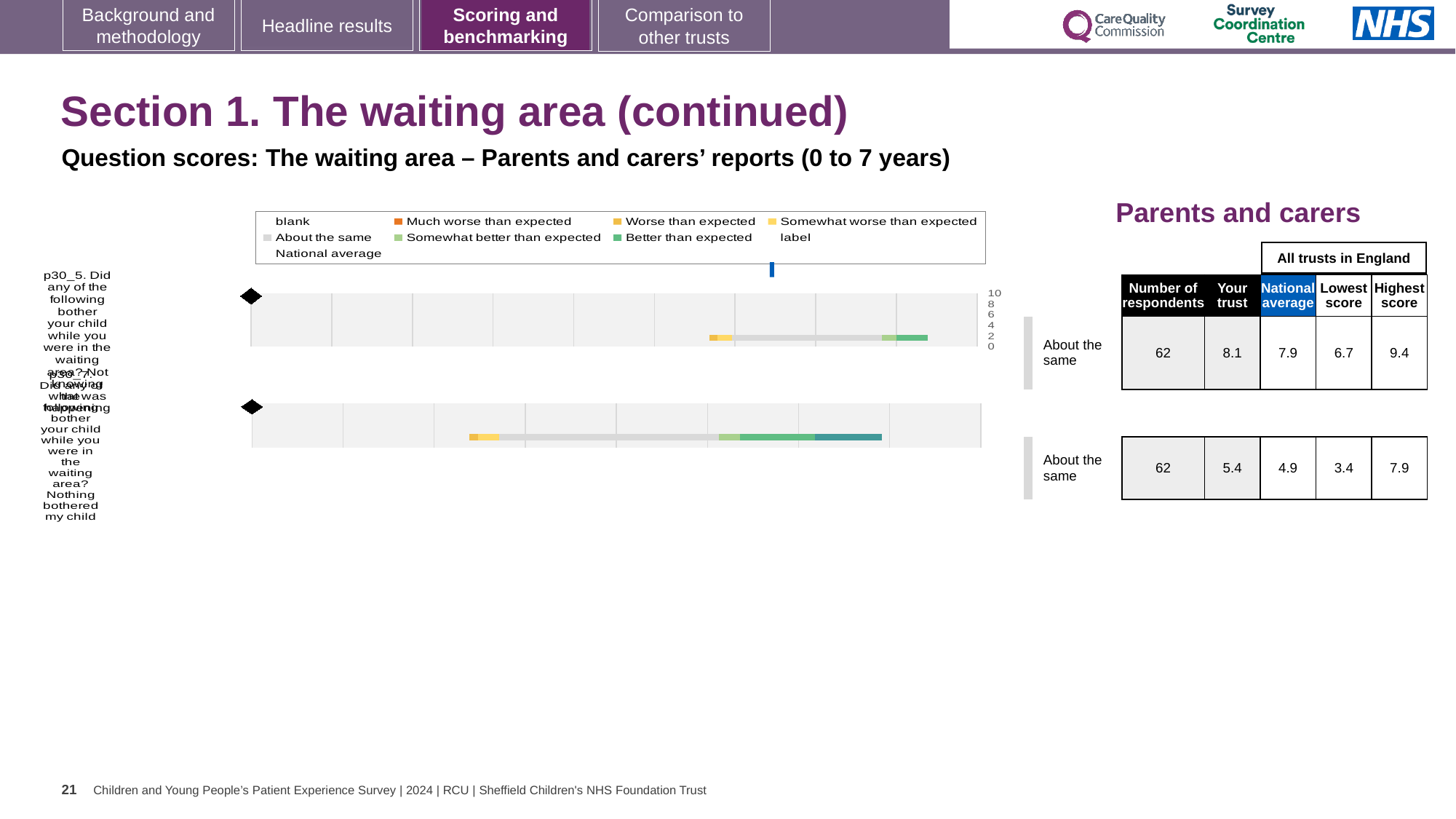
Which legend entry is shown in orange? Much worse than expected How many entries does the chart legend list? 9 For question p30_7, what is the difference between the 'Your trust' score (5.4) and the national average (4.9)? 0.5 In the table beside the chart, what is the national average for question p30_7 (Nothing bothered my child)? 4.9 What is the highest tick value shown on the chart's score axis? 10 What benchmark category is shown next to both bars in the chart? About the same In the table beside the chart, what is the 'Your trust' score for question p30_5 (Not knowing what was happening)? 8.1 For question p30_5, which is larger: the 'Your trust' score or the national average? Your trust In the table beside the chart, how many respondents answered question p30_5? 62 How many questions (bars) are plotted in the chart? 2 For question p30_5, what is the difference between the highest score (9.4) and the lowest score (6.7) across all trusts in England? 2.7 What kind of chart is shown on the slide? bar chart